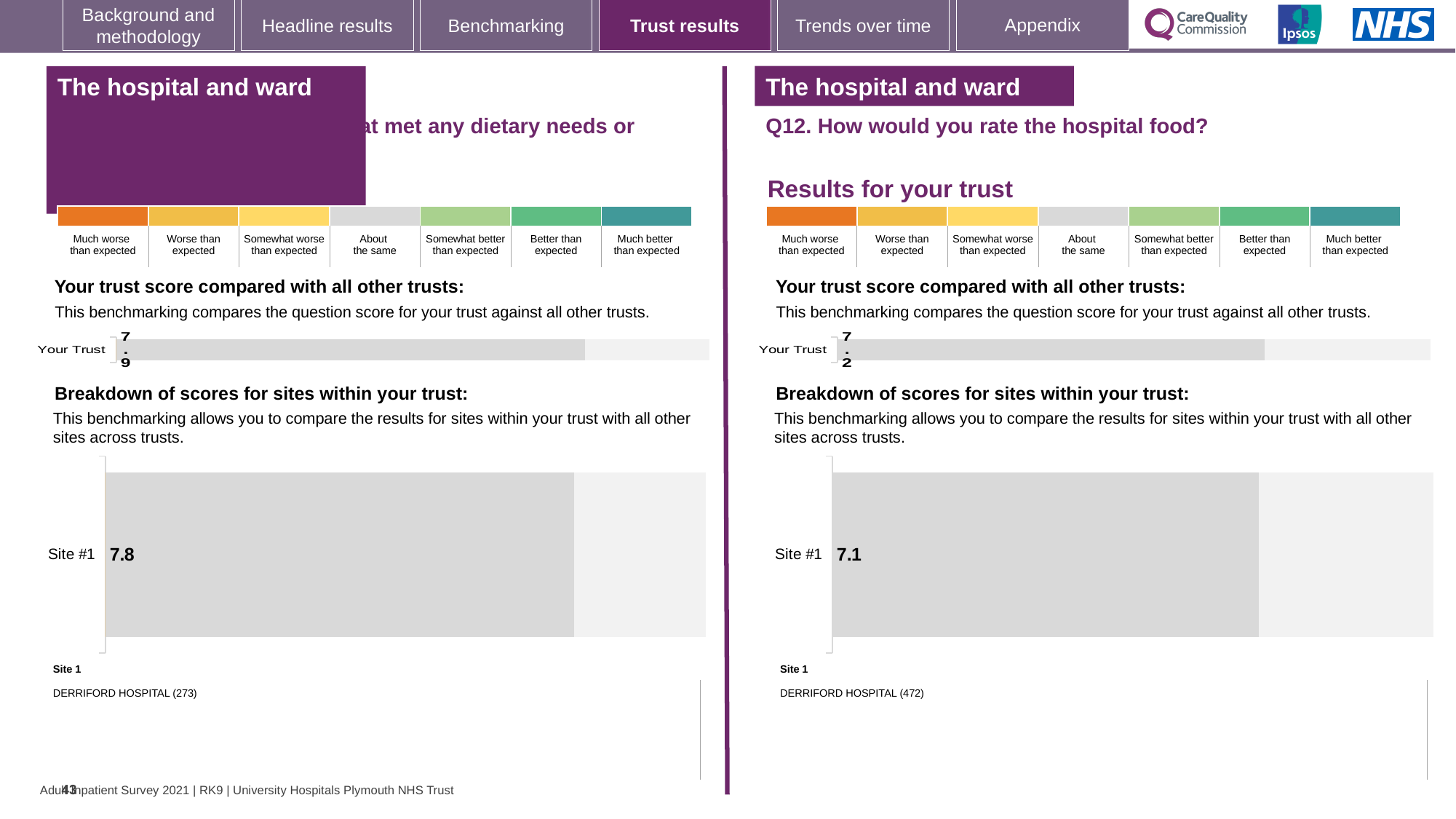
How many categories does the colour key above the 'Your trust score compared with all other trusts' chart on the right half of the slide show? 7 On the left half of the slide, what is the score shown for Site #1 in the 'Breakdown of scores for sites within your trust' chart? 7.8 On the right half of the slide (Q12. How would you rate the hospital food?), what is the score shown for Site #1 in the 'Breakdown of scores for sites within your trust' chart? 7.1 On the right half of the slide (Q12), which site name is listed under 'Site 1' below the breakdown chart? DERRIFORD HOSPITAL (472) What kind of chart is used to show the Site #1 score in the 'Breakdown of scores for sites within your trust' section on the right half of the slide? Bar chart On the right half of the slide (Q12), how many sites are shown in the 'Breakdown of scores for sites within your trust' chart? 1 Which is larger: the Your Trust score on the left half of the slide or the Your Trust score on the right half (Q12)? Left half (7.9) Which is larger: the Site #1 score on the left half of the slide or the Site #1 score on the right half (Q12)? Left half (7.8) On the left half of the slide, what is the score shown for Your Trust in the 'Your trust score compared with all other trusts' chart? 7.9 On the right half of the slide (Q12), what is the difference between the Your Trust score and the Site #1 score? 0.1 On the left half of the slide, what is the difference between the Your Trust score and the Site #1 score? 0.1 On the right half of the slide (Q12. How would you rate the hospital food?), what is the score shown for Your Trust in the 'Your trust score compared with all other trusts' chart? 7.2